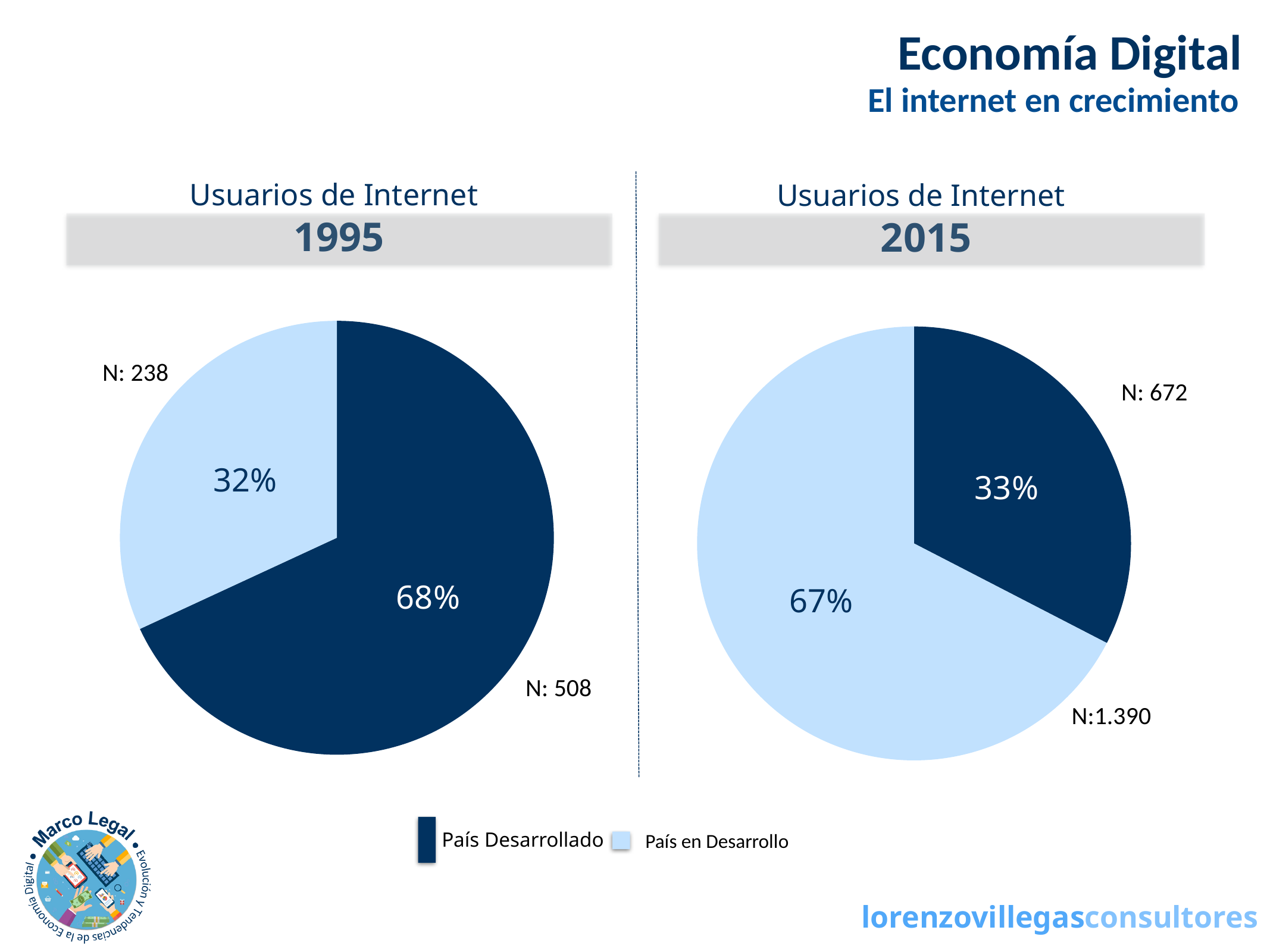
In the 1995 pie chart, what is the difference in percentage points between the País Desarrollado and País en Desarrollo shares? 36 In the 1995 pie chart, what N value is printed next to the País Desarrollado slice? N: 508 In the 2015 pie chart, what N value is printed next to the País Desarrollado slice? N: 672 In the 2015 'Usuarios de Internet' pie chart, what share is shown for País en Desarrollo? 67% In the 2015 pie chart, which category has the smallest slice? País Desarrollado What type of chart is used on the slide for the 1995 and 2015 'Usuarios de Internet' data? Pie chart In the 2015 pie chart, what N value is printed next to the País en Desarrollo slice? N:1.390 In the 1995 pie chart, what N value is printed next to the País en Desarrollo slice? N: 238 In the 2015 'Usuarios de Internet' pie chart, what share is shown for País Desarrollado? 33% In the 1995 'Usuarios de Internet' pie chart, what share is shown for País Desarrollado? 68% In the 1995 pie chart, which category has the largest slice? País Desarrollado